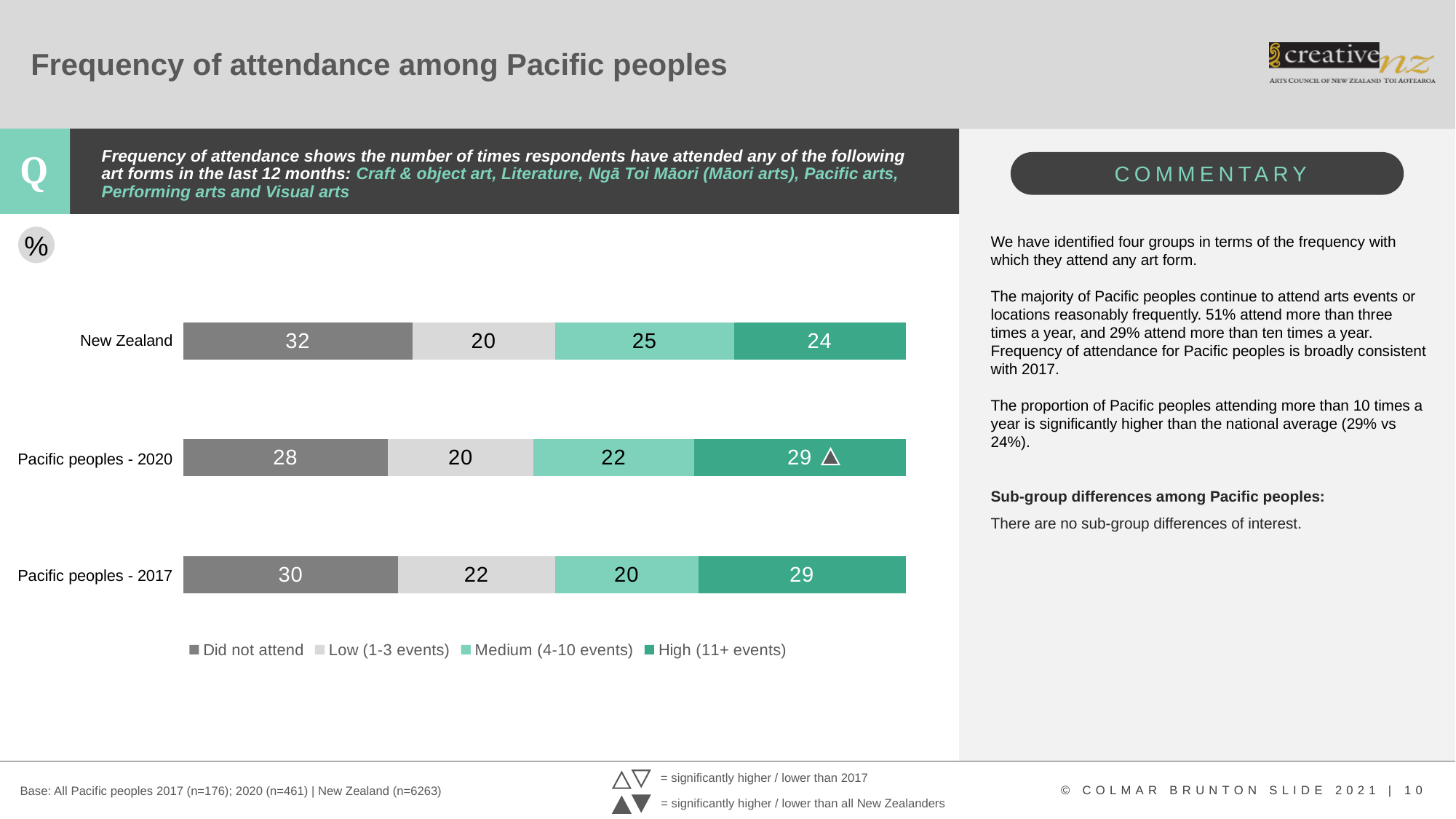
How many series does the legend list? 4 What is the total of the stacked bar for Pacific peoples - 2020? 99 What is the value for 'High (11+ events)' for Pacific peoples - 2020? 29 What is the value for 'Medium (4-10 events)' for New Zealand? 25 What is the value for 'Low (1-3 events)' for Pacific peoples - 2017? 22 How many categories (bars) are shown in the chart? 3 What is the difference between the 'High (11+ events)' values for Pacific peoples - 2020 and New Zealand? 5 Which is larger: the 'Did not attend' value for Pacific peoples - 2017 or for Pacific peoples - 2020? Pacific peoples - 2017 Which category has the highest 'Did not attend' value? New Zealand What is the value for 'Did not attend' for New Zealand? 32 What kind of chart is shown on the slide? Stacked bar chart Which category has the lowest 'Medium (4-10 events)' value? Pacific peoples - 2017